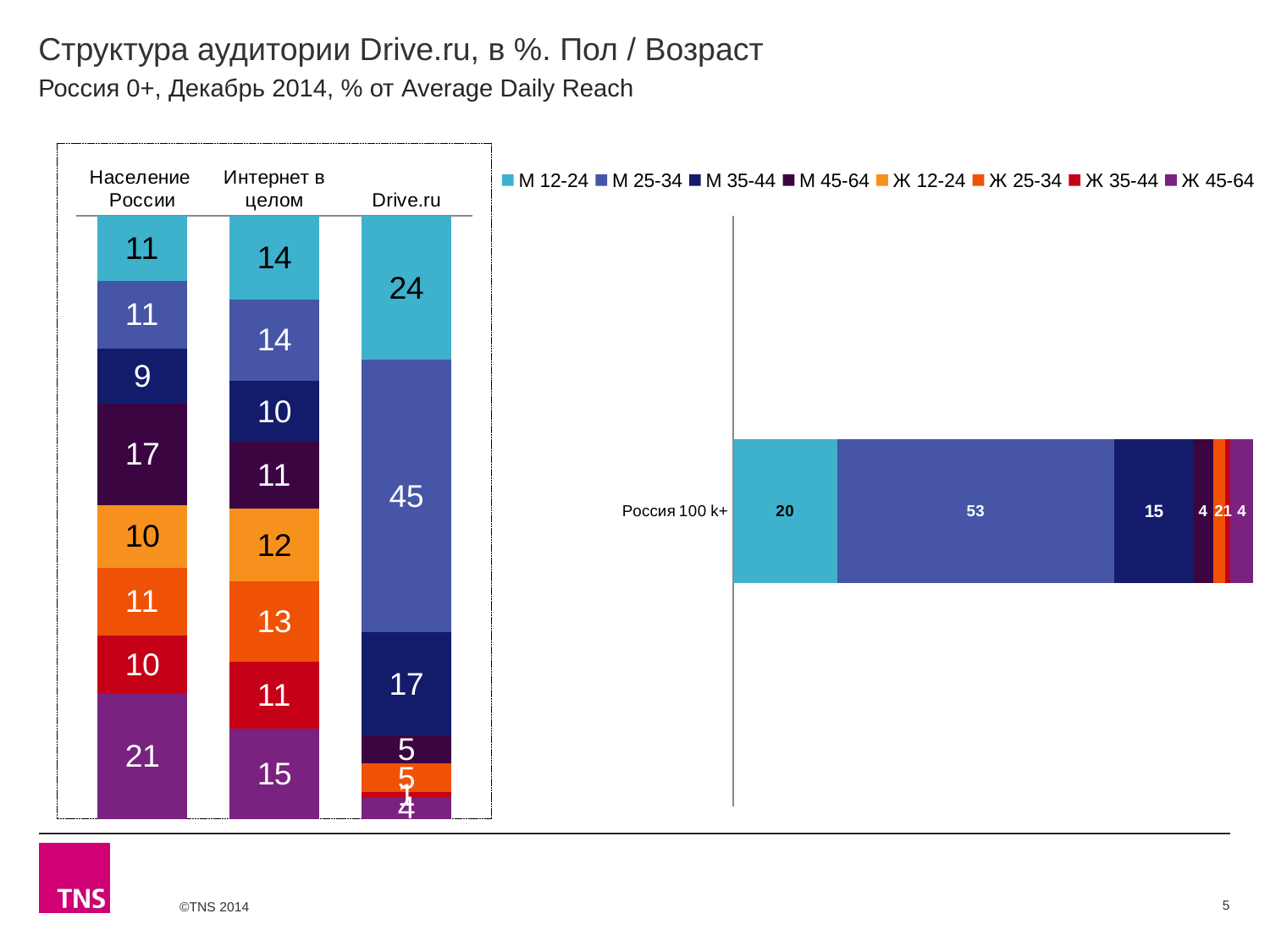
In the right chart (Россия 100 k+), which series has the largest segment? M 25-34 In the right chart (Россия 100 k+), what is the value for M 25-34? 53 What kind of chart is the left chart? Stacked bar chart In the left chart, which series has the largest segment in the Drive.ru column? M 25-34 In the left chart, what is the difference between the M 12-24 value for Drive.ru and the M 12-24 value for Население России? 13 In the left chart, what is the value for M 25-34 in the Drive.ru column? 45 In the left chart, which column has the larger Ж 45-64 value: Население России or Интернет в целом? Население России In the left chart, what is the value for M 12-24 in the Интернет в целом column? 14 How many series does the legend list? 8 In the right chart (Россия 100 k+), what is the value for M 35-44? 15 In the right chart (Россия 100 k+), what is the value for M 12-24? 20 In the left chart, what is the value for Ж 45-64 in the Население России column? 21